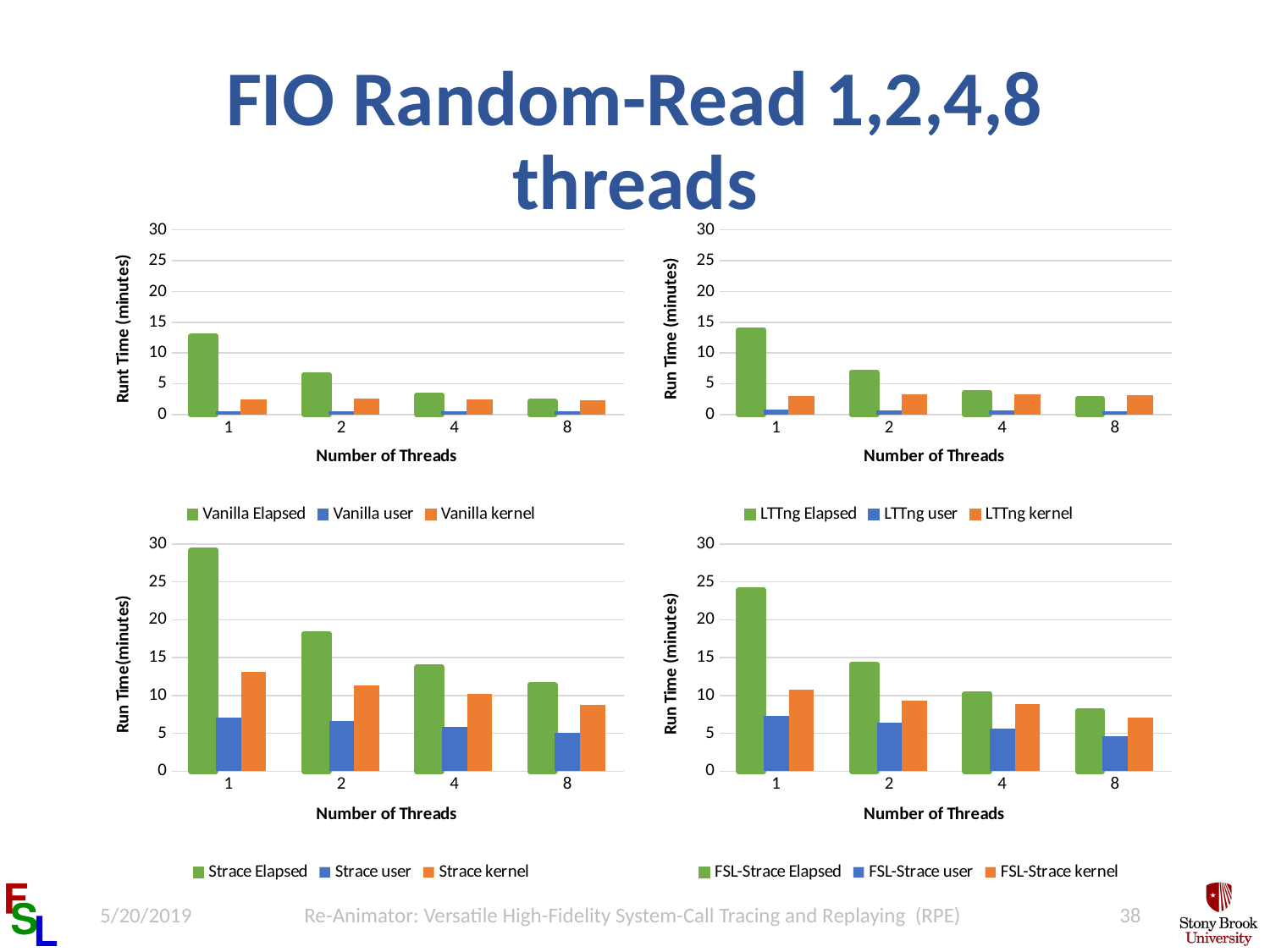
In the bottom-right chart (FSL-Strace), is the FSL-Strace Elapsed value for 1 thread greater or less than 25? less In the bottom-left chart (Strace), at 1 thread, which is larger: Strace kernel or Strace user? Strace kernel In the bottom-left chart (Strace), is the Strace Elapsed value for 1 thread greater or less than 25? greater What kind of chart is the bottom-left chart (Strace)? bar chart In the top-left chart (Vanilla), how many series does the legend list? 3 In the top-left chart (Vanilla), is the Vanilla Elapsed value for 1 thread greater or less than 10? greater In the top-right chart (LTTng), which is larger: LTTng Elapsed at 2 threads or at 4 threads? 2 threads In the top-left chart (Vanilla), does Vanilla Elapsed rise or fall as the number of threads increases? fall In the bottom-left chart (Strace), at which number of threads is Strace Elapsed highest? 1 What is the x-axis title of the top-right chart (LTTng)? Number of Threads In the bottom-right chart (FSL-Strace), at which number of threads is FSL-Strace user lowest? 8 In the bottom-right chart (FSL-Strace), how many thread-count categories are shown on the x axis? 4